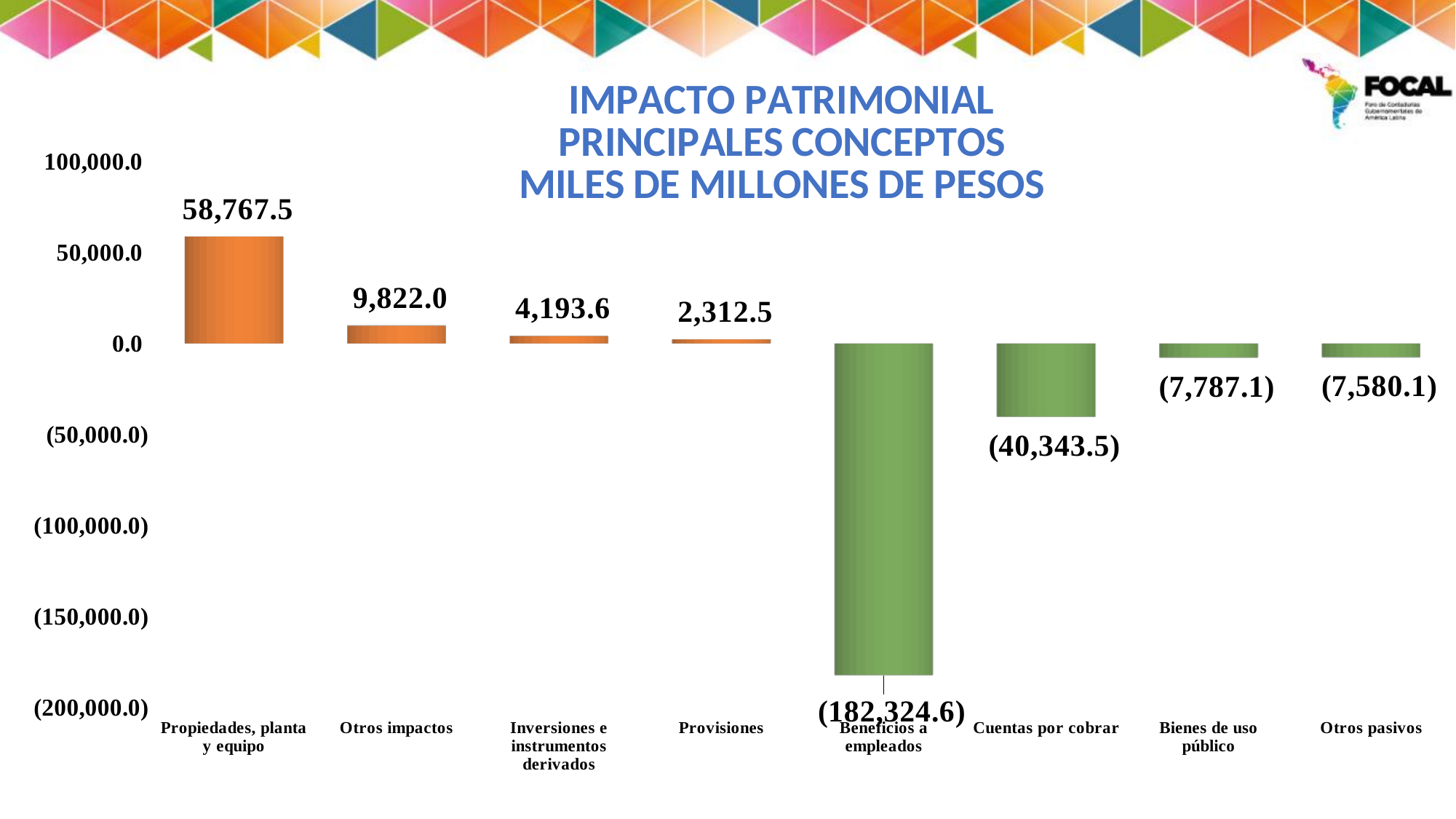
What is the title of the chart? IMPACTO PATRIMONIAL PRINCIPALES CONCEPTOS MILES DE MILLONES DE PESOS What is the value for Beneficios a empleados? (182,324.6) Which category has the highest value? Propiedades, planta y equipo Which is larger, the value for Otros impactos or the value for Inversiones e instrumentos derivados? Otros impactos How many categories are shown on the x axis? 8 What is the value for Otros pasivos? (7,580.1) What kind of chart is shown on the slide? Bar chart What is the difference between the values for Propiedades, planta y equipo and Otros impactos? 48,945.5 What is the value for Propiedades, planta y equipo? 58,767.5 Which category has the lowest value? Beneficios a empleados What is the value for Cuentas por cobrar? (40,343.5) What is the value for Provisiones? 2,312.5